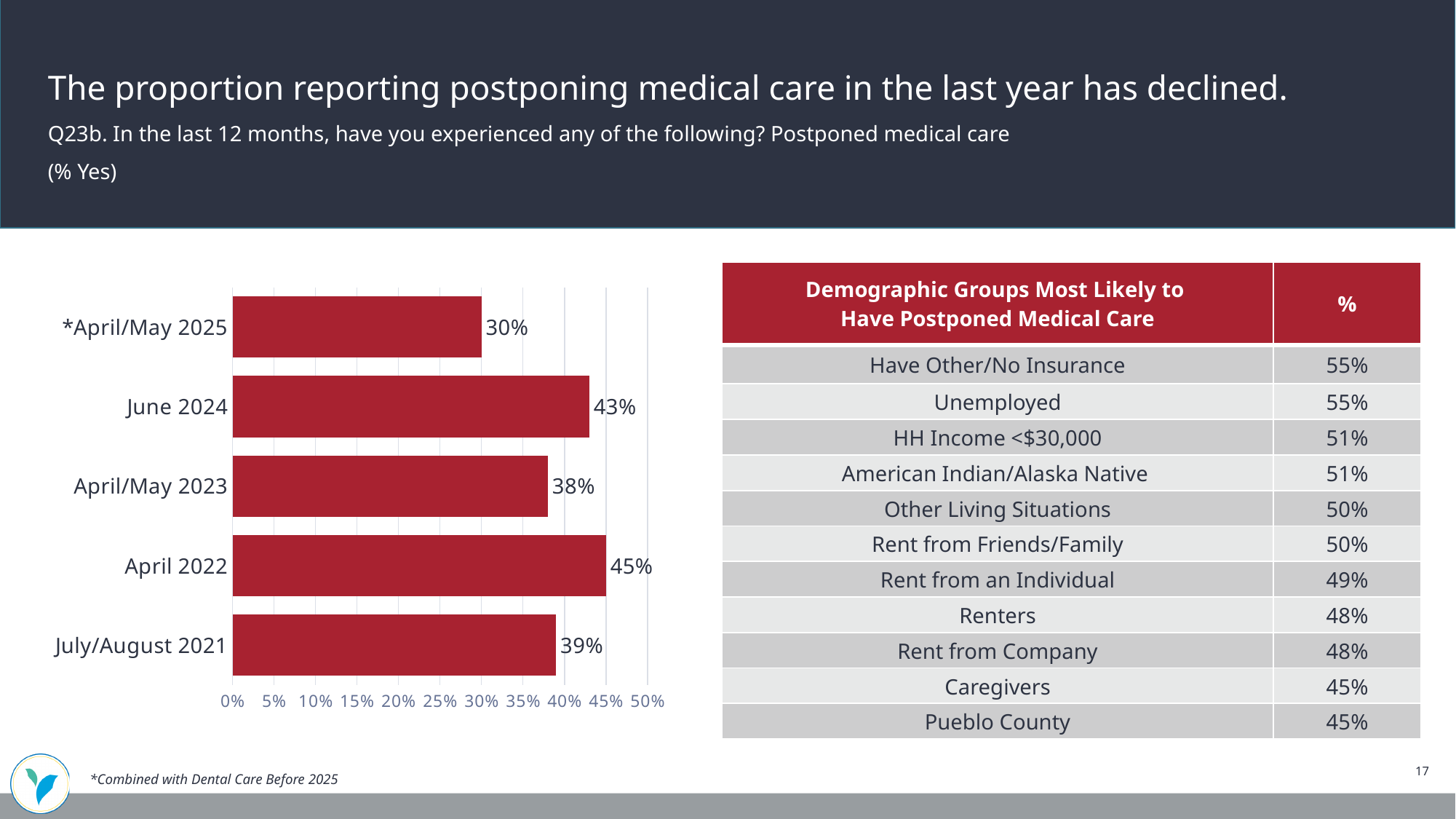
What is the maximum value shown on the chart's percentage axis? 50% What kind of chart is used to show the proportion postponing medical care over time? Bar chart Is the value for June 2024 greater or less than 40%? greater How many time periods are shown in the bar chart? 5 What is the value shown for July/August 2021? 39% Which is larger, the value for April/May 2023 or the value for July/August 2021? July/August 2021 What is the value shown for June 2024? 43% What is the difference between the June 2024 value and the April/May 2025 value? 13 percentage points Which period has the lowest proportion reporting postponed medical care? April/May 2025 What is the difference between the April 2022 value and the April/May 2023 value? 7 percentage points What percentage reported postponing medical care in April/May 2025? 30% Which period has the highest proportion reporting postponed medical care? April 2022